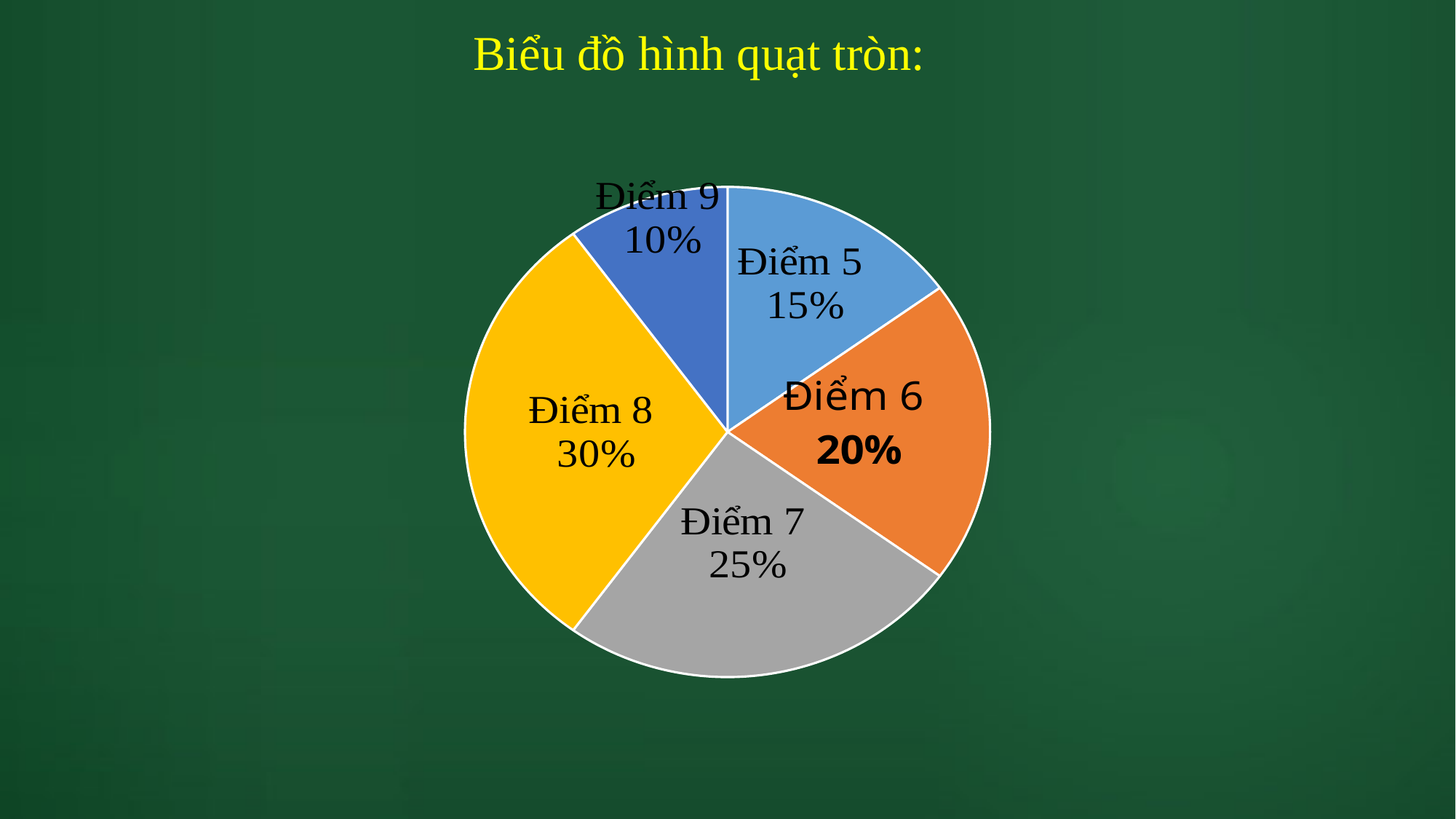
What is the difference between the values for Điểm 6 and Điểm 9? 10% What is the difference in percentage points between Điểm 8 and Điểm 7? 5% Which category has the largest slice of the pie? Điểm 8 What is the title shown above the chart? Biểu đồ hình quạt tròn: What percentage of the pie chart does Điểm 8 represent? 30% Which category has the smallest slice of the pie? Điểm 9 What type of chart is shown on the slide? Pie chart How many categories (slices) are shown in the pie chart? 5 What percentage is labelled for Điểm 6? 20% What is the value shown for Điểm 9? 10% Which is larger, the slice for Điểm 7 or the slice for Điểm 5? Điểm 7 What is the value shown for Điểm 5? 15%